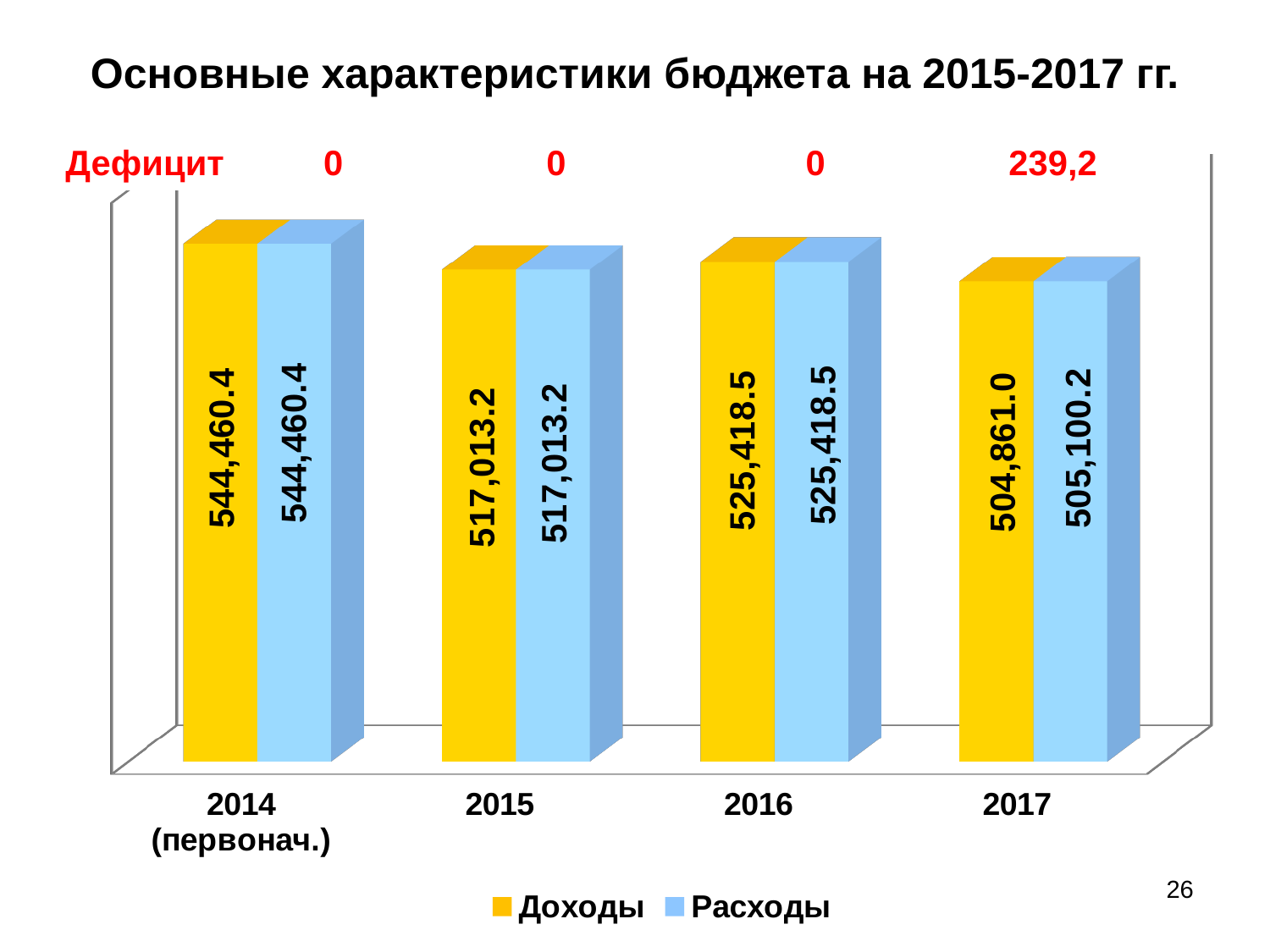
What is the difference between Расходы and Доходы for 2017? 239.2 How many series does the legend list? 2 What is the difference between Доходы for 2014 (первонач.) and Доходы for 2015? 27,447.2 Which year has the lowest value of Доходы? 2017 How many year categories are shown on the x axis? 4 Which is larger, Доходы for 2015 or Доходы for 2016? 2016 What is the value of Расходы for 2016? 525,418.5 What is the Дефицит value shown above the 2017 bars? 239,2 What is the value of Расходы for 2017? 505,100.2 What is the value of Доходы for 2015? 517,013.2 What kind of chart is shown on the slide? bar chart Which year has the highest value of Доходы? 2014 (первонач.)